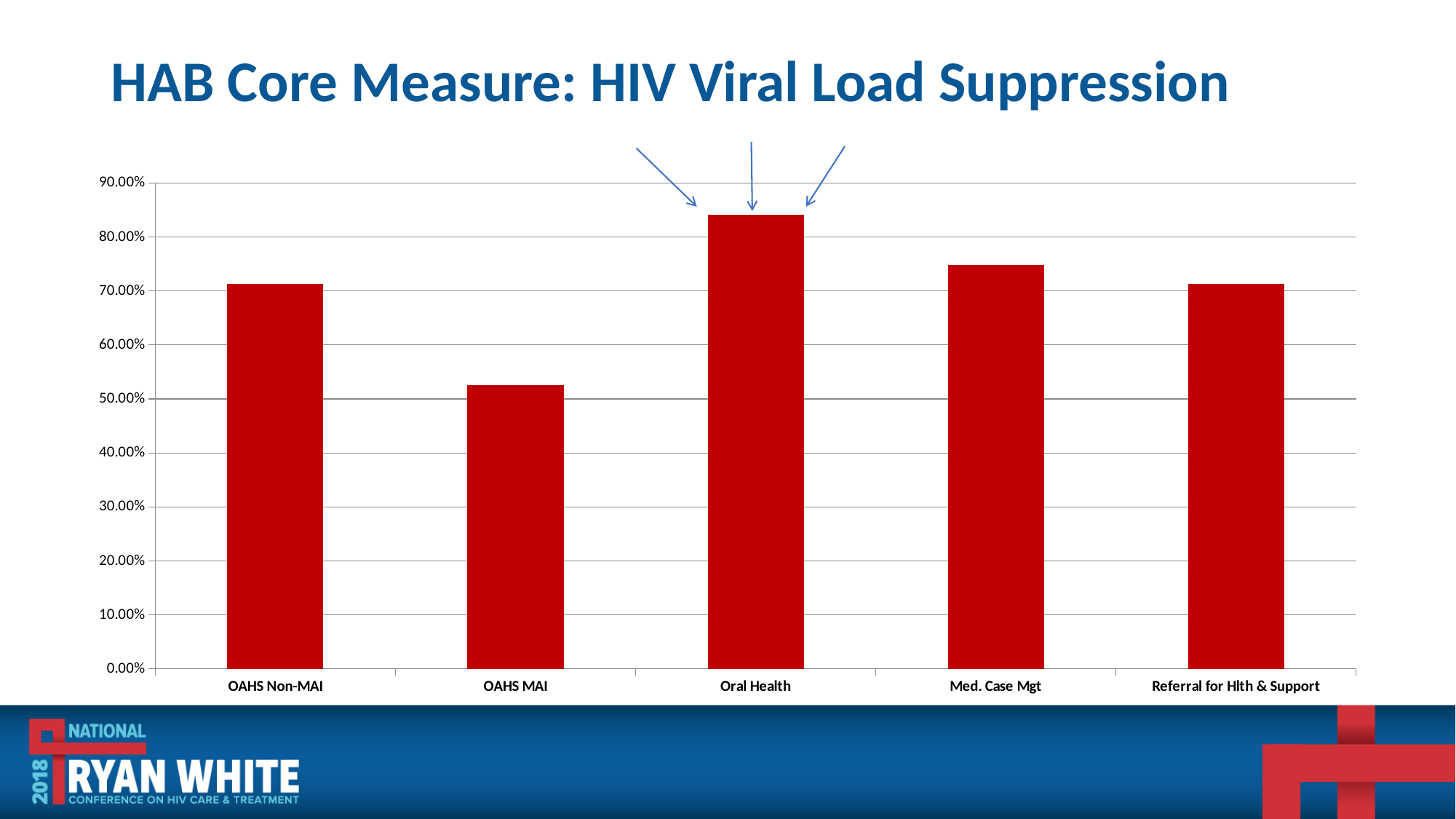
Is the value for OAHS MAI greater or less than 60.00%? less What is the title of the slide containing the chart? HAB Core Measure: HIV Viral Load Suppression Which category has the lowest HIV viral load suppression value? OAHS MAI Is the value for Med. Case Mgt greater or less than 80.00%? less Is the value for Oral Health greater or less than 80.00%? greater What kind of chart is shown on the slide? bar chart Which is larger, the value for Oral Health or the value for Med. Case Mgt? Oral Health Which category has the highest HIV viral load suppression value? Oral Health How many categories are shown on the x axis of the chart? 5 Which is larger, the value for OAHS MAI or the value for OAHS Non-MAI? OAHS Non-MAI